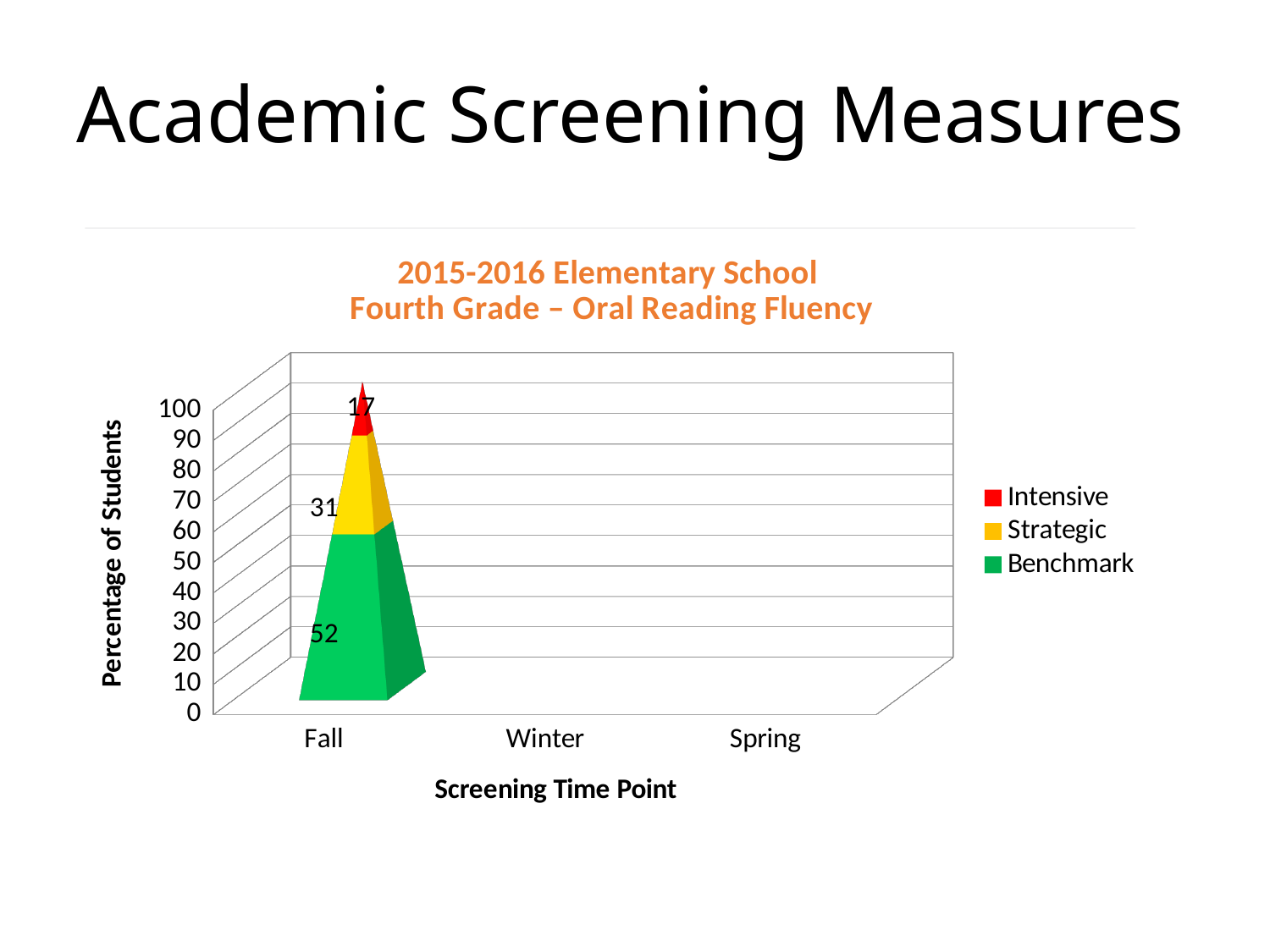
What is the Benchmark value for Fall? 52 For Fall, is the Benchmark value or the Intensive value larger? Benchmark What is the total of the stacked bar for Fall? 100 What is the Intensive value for Fall? 17 What is the title of the chart? 2015-2016 Elementary School Fourth Grade – Oral Reading Fluency Which series has the largest value for Fall? Benchmark How many series does the legend list? 3 What is the difference between the Benchmark and Strategic values for Fall? 21 What is the difference between the Strategic and Intensive values for Fall? 14 What is the Strategic value for Fall? 31 How many screening time points are shown on the x axis? 3 Which series has the smallest value for Fall? Intensive